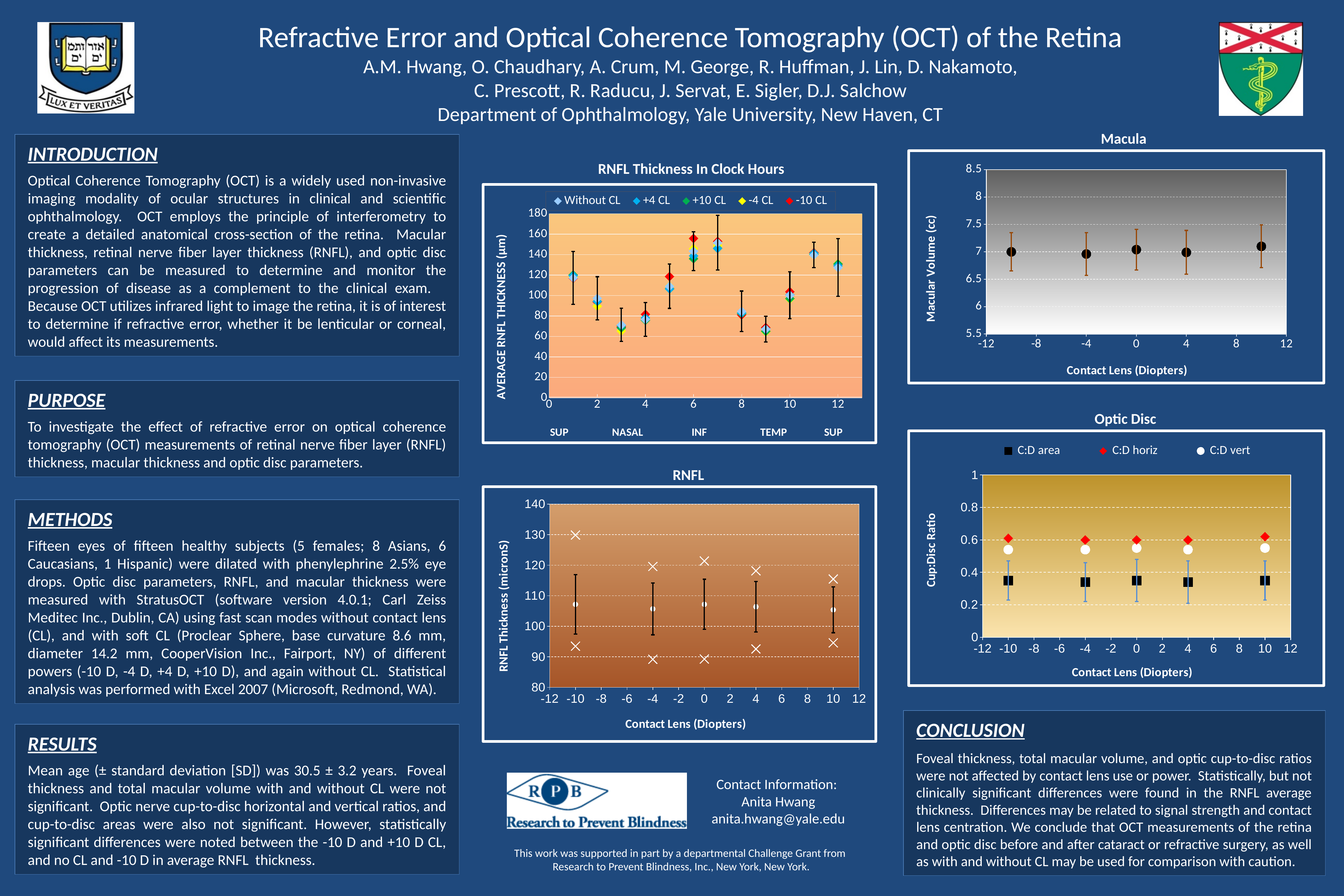
What kind of chart is the 'RNFL Thickness In Clock Hours' chart? scatter chart On the 'RNFL Thickness In Clock Hours' chart, what is the y-axis title? AVERAGE RNFL THICKNESS (µm) On the 'RNFL Thickness In Clock Hours' chart, are the values at clock hour 3 greater or less than 80? less On the 'RNFL Thickness In Clock Hours' chart, how many series does the legend list? 5 On the 'Macula' chart, how many data points are plotted? 5 On the 'Optic Disc' chart, which is larger at 0 diopters: C:D horiz or C:D area? C:D horiz On the 'Macula' chart, what is the x-axis title? Contact Lens (Diopters) On the 'Optic Disc' chart, is the C:D area value at -10 diopters greater or less than 0.5? less On the 'Optic Disc' chart, how many series does the legend list? 3 On the 'RNFL' chart, is the mean RNFL thickness at -10 diopters greater or less than 100? greater